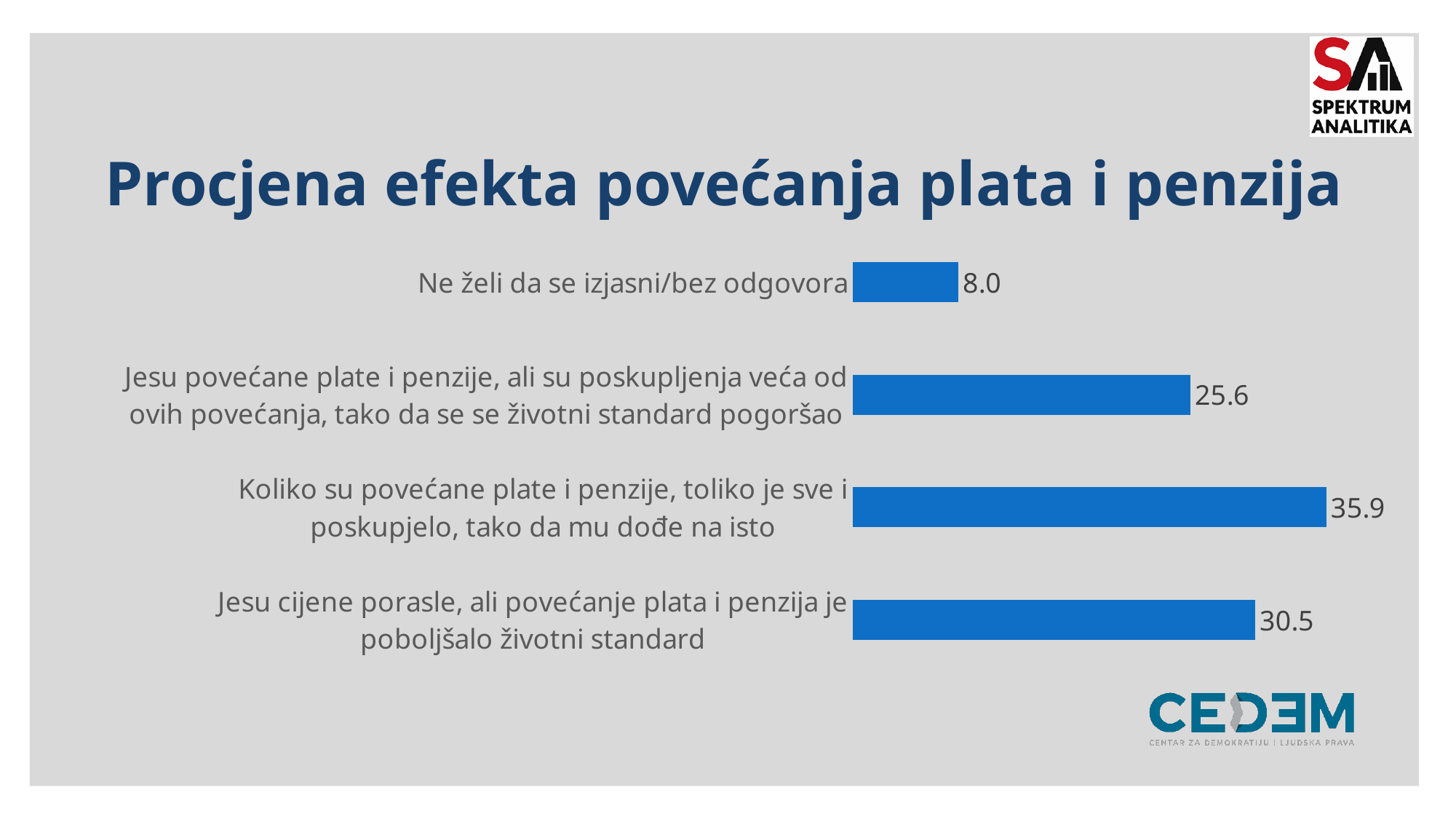
Which is larger: the value for "Jesu cijene porasle, ali povećanje plata i penzija je poboljšalo životni standard" or the value for "Jesu povećane plate i penzije, ali su poskupljenja veća od ovih povećanja, tako da se se životni standard pogoršao"? Jesu cijene porasle, ali povećanje plata i penzija je poboljšalo životni standard What is the value for "Koliko su povećane plate i penzije, toliko je sve i poskupjelo, tako da mu dođe na isto"? 35.9 Which category has the highest value? Koliko su povećane plate i penzije, toliko je sve i poskupjelo, tako da mu dođe na isto What is the difference between the value for "Koliko su povećane plate i penzije, toliko je sve i poskupjelo, tako da mu dođe na isto" and the value for "Jesu cijene porasle, ali povećanje plata i penzija je poboljšalo životni standard"? 5.4 What kind of chart is shown on the slide? Bar chart What is the title of the slide? Procjena efekta povećanja plata i penzija How many categories are shown in the chart? 4 What is the difference between the value for "Jesu povećane plate i penzije, ali su poskupljenja veća od ovih povećanja, tako da se se životni standard pogoršao" and the value for "Ne želi da se izjasni/bez odgovora"? 17.6 What is the value for "Jesu cijene porasle, ali povećanje plata i penzija je poboljšalo životni standard"? 30.5 Which category has the lowest value? Ne želi da se izjasni/bez odgovora What is the value for "Jesu povećane plate i penzije, ali su poskupljenja veća od ovih povećanja, tako da se se životni standard pogoršao"? 25.6 What is the value for "Ne želi da se izjasni/bez odgovora"? 8.0